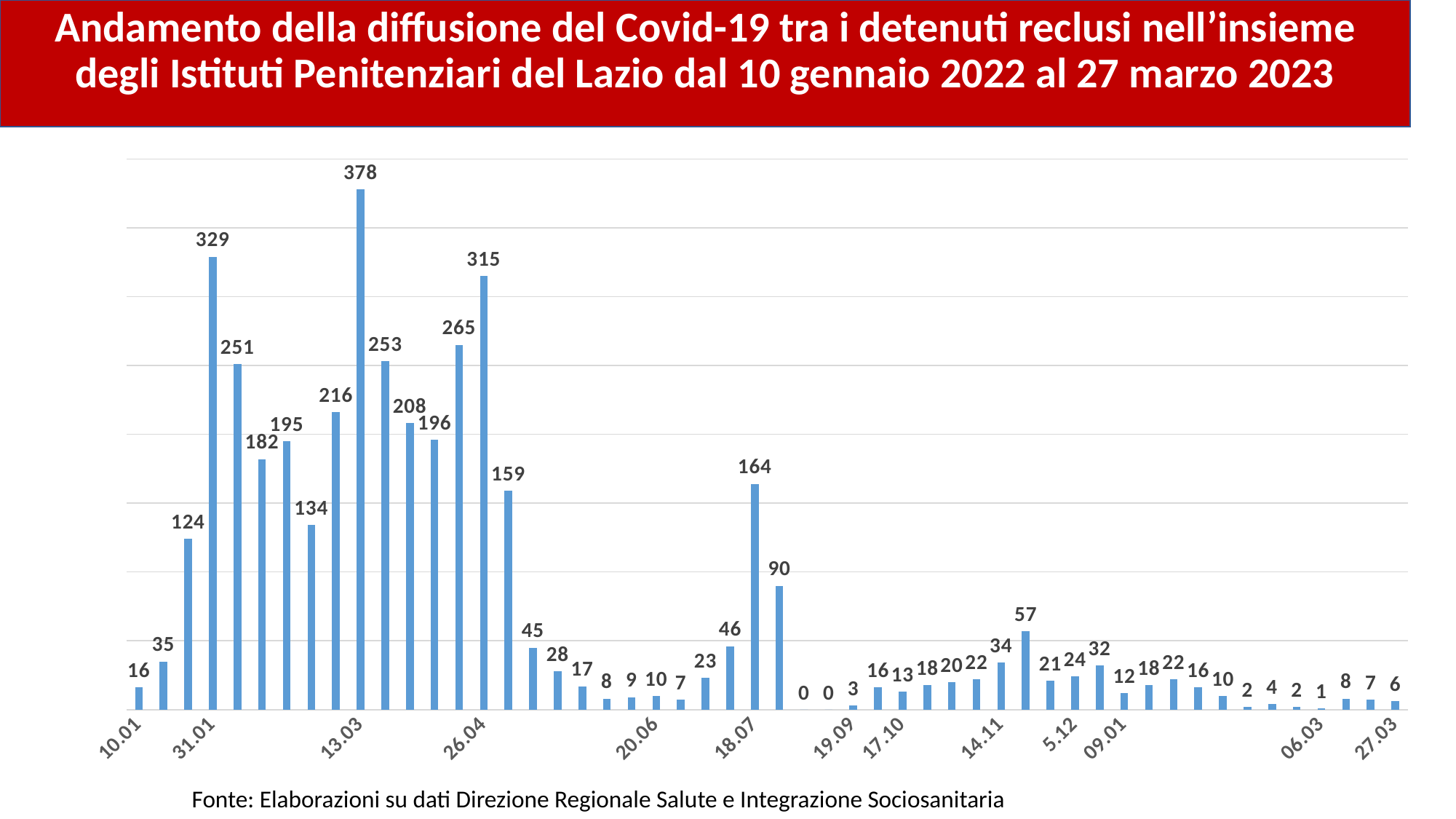
What is the value for 31.01? 329 What source is cited below the chart? Elaborazioni su dati Direzione Regionale Salute e Integrazione Sociosanitaria What is the difference between the values for 13.03 and 26.04? 63 What is the value for 14.11? 34 What is the value for 18.07? 164 What is the value for 10.01? 16 What is the highest value shown in the chart, and on which date does it occur? 378 on 13.03 Which date has the larger value, 31.01 or 26.04? 31.01 Do the values generally rise or fall between 26.04 and 20.06? Fall What is the value for 27.03? 6 What is the value for 26.04? 315 What kind of chart is shown on the slide? Bar chart